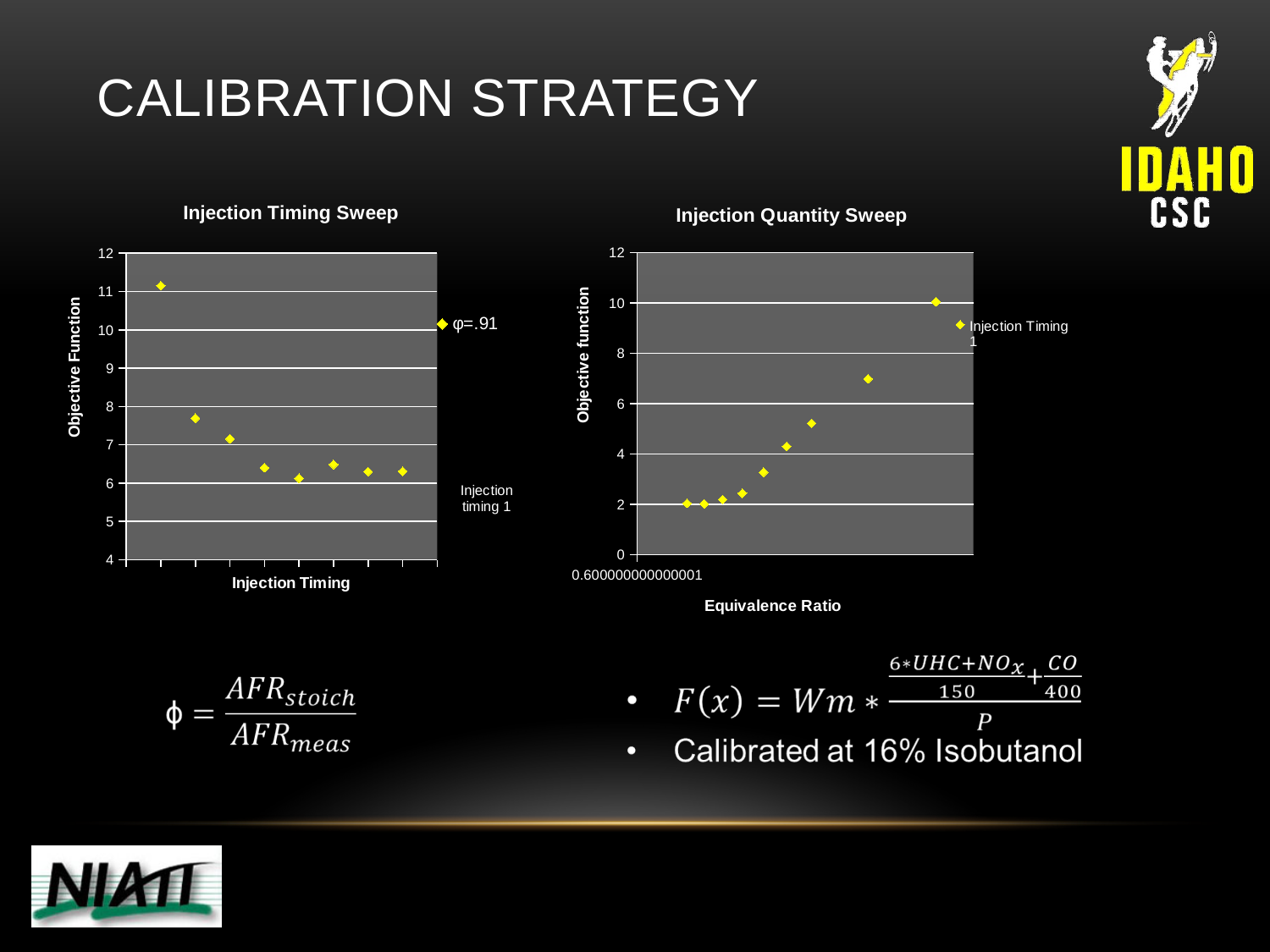
What is the y-axis title of the Injection Quantity Sweep chart? Objective function In the Injection Quantity Sweep chart, do the values rise or fall as the equivalence ratio increases along the x axis? rise What kind of chart is the Injection Timing Sweep chart? scatter chart How many data points are plotted in the Injection Timing Sweep chart? 8 In the Injection Quantity Sweep chart, is the value of the first (leftmost) point greater or less than 4? less In the Injection Quantity Sweep chart, is the value of the last (rightmost) point greater or less than 8? greater In the Injection Timing Sweep chart, do the values generally rise or fall from the first point to the last point along the x axis? fall In the Injection Timing Sweep chart, is the value of the first (leftmost) point greater or less than 10? greater How many series does the legend of the Injection Timing Sweep chart list? 1 How many data points are plotted in the Injection Quantity Sweep chart? 9 What legend entry is shown for the Injection Timing Sweep chart? φ=.91 What kind of chart is the Injection Quantity Sweep chart? scatter chart